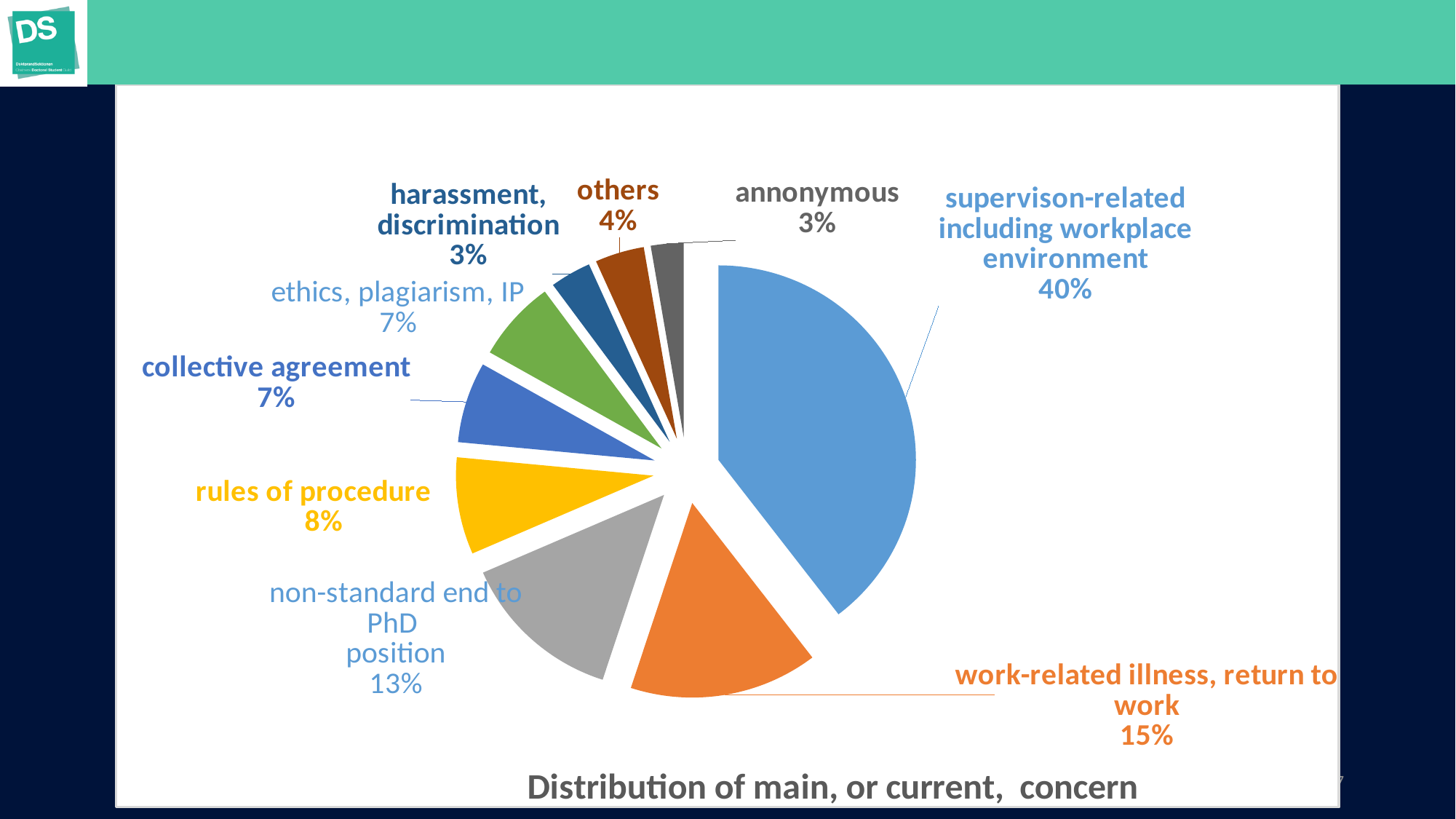
What is the difference in percentage points between 'supervison-related including workplace environment' and 'work-related illness, return to work'? 25 Which category has the largest share of the pie? supervison-related including workplace environment What is the title of the chart? Distribution of main, or current, concern How many slices does the pie chart have? 9 What percentage is shown for 'others'? 4% What percentage is shown for 'non-standard end to PhD position'? 13% What percentage is shown for 'harassment, discrimination'? 3% What share of the pie is labelled 'supervison-related including workplace environment'? 40% What percentage is shown for 'rules of procedure'? 8% What percentage is shown for 'work-related illness, return to work'? 15% Which is larger, the share for 'rules of procedure' or the share for 'collective agreement'? rules of procedure What kind of chart is shown on the slide? pie chart